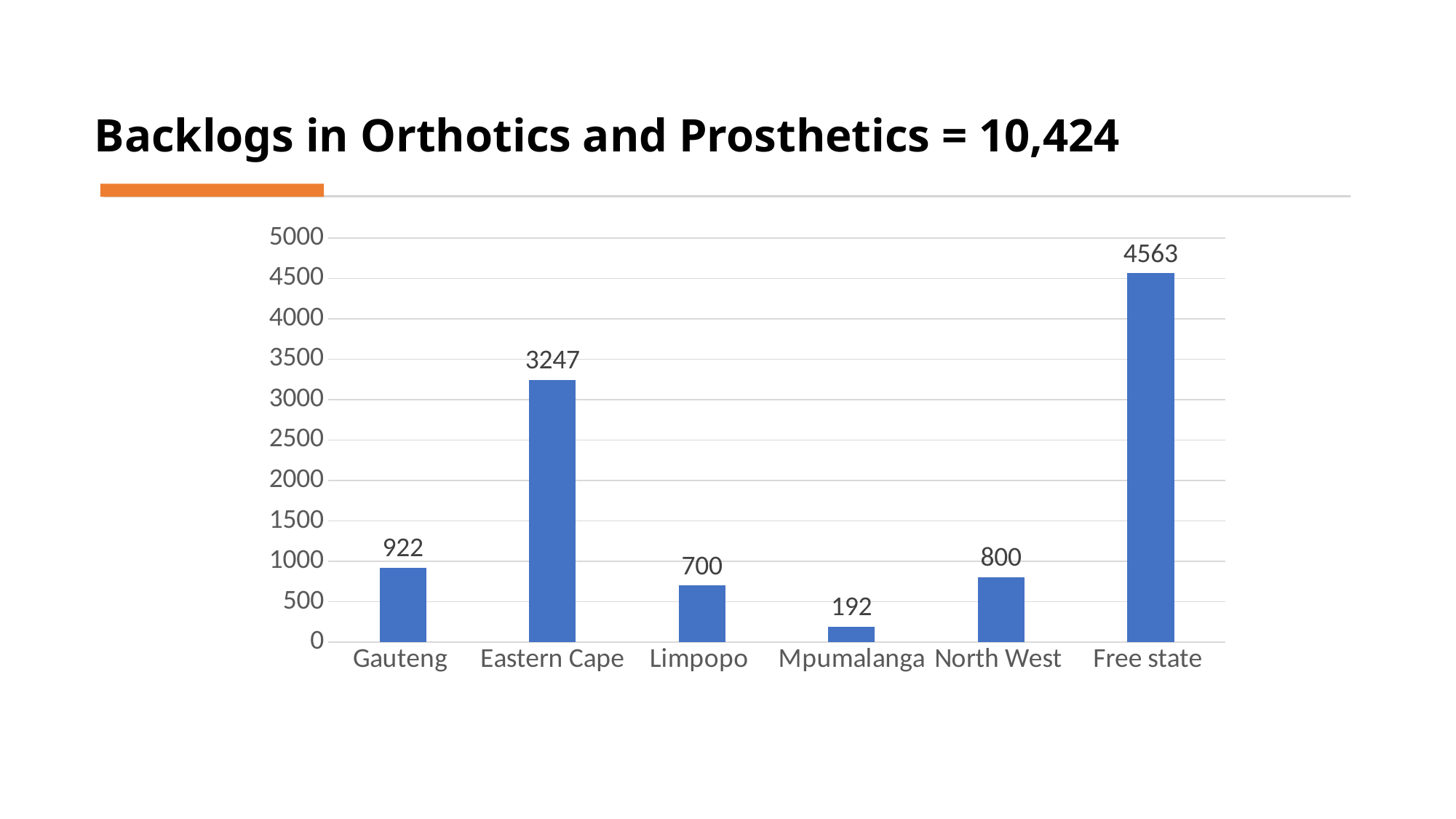
What is the backlog value for Mpumalanga? 192 How many provinces are shown on the chart? 6 Which province has the lowest backlog? Mpumalanga What is the backlog value for Free state? 4563 Which has a larger backlog, Limpopo or North West? North West What kind of chart is shown on the slide? Bar chart What is the difference between the backlogs of Gauteng and North West? 122 Which province has the highest backlog? Free state What is the backlog value for Eastern Cape? 3247 What is the difference between the backlogs of Free state and Eastern Cape? 1316 Is the value for Eastern Cape greater or less than 3000? greater What is the backlog value for Gauteng? 922